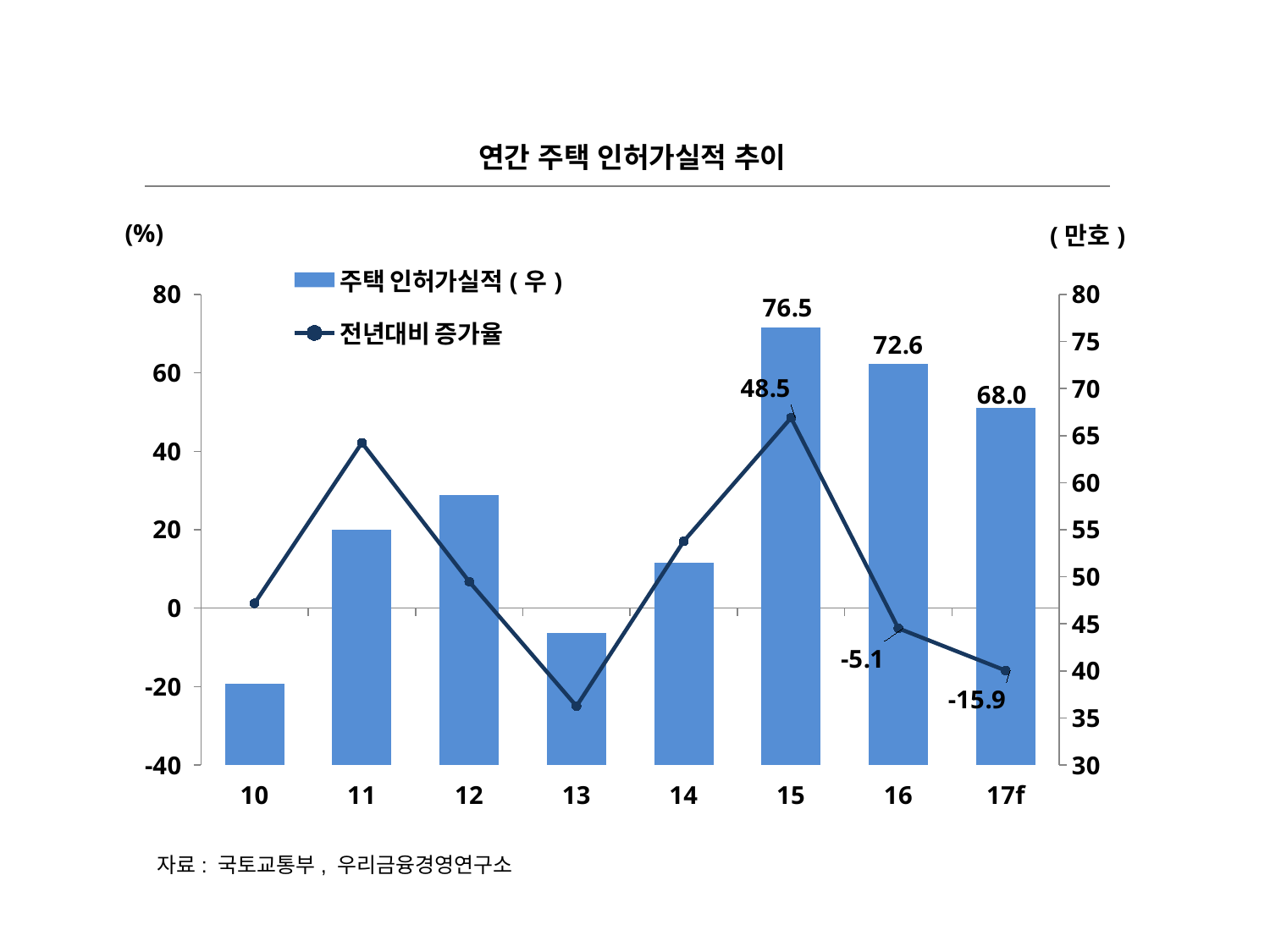
How many years are shown on the x axis? 8 What is the 전년대비 증가율 for 15? 48.5 What is the value of 주택 인허가실적 for 16? 72.6 Which year has the lowest 전년대비 증가율? 13 What is the value of 주택 인허가실적 for 17f? 68.0 Which year has the highest 주택 인허가실적 bar? 15 What is the difference between the 주택 인허가실적 values for 15 and 16? 3.9 Do the 주택 인허가실적 bars rise or fall from 15 to 17f? fall What is the 전년대비 증가율 for 17f? -15.9 What is the value of 주택 인허가실적 for 15? 76.5 Is the 주택 인허가실적 bar for 10 greater or less than 45? less How many series does the legend list? 2